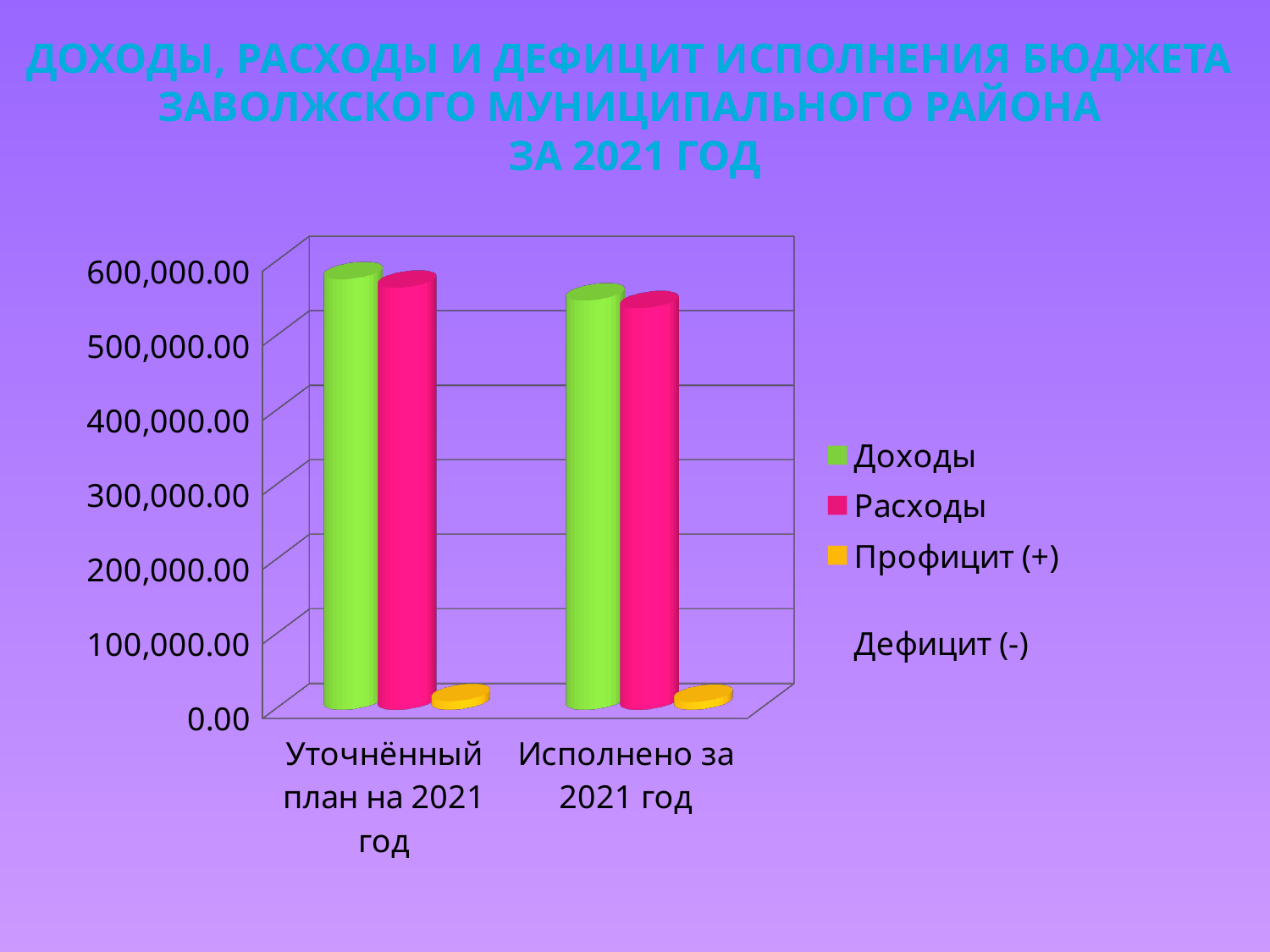
What is the title of the slide containing the chart? ДОХОДЫ, РАСХОДЫ И ДЕФИЦИТ ИСПОЛНЕНИЯ БЮДЖЕТА ЗАВОЛЖСКОГО МУНИЦИПАЛЬНОГО РАЙОНА ЗА 2021 ГОД Does the value of Доходы rise or fall from Уточнённый план на 2021 год to Исполнено за 2021 год? fall Which colour represents the Расходы series in the chart? pink Is the value of Доходы for Уточнённый план на 2021 год greater or less than 500,000.00? greater What kind of chart is shown on the slide? bar chart How many categories are shown on the x axis of the chart? 2 How many series does the chart legend list? 3 Does the value of Расходы rise or fall from Уточнённый план на 2021 год to Исполнено за 2021 год? fall Is the value of Расходы for Исполнено за 2021 год greater or less than 500,000.00? greater Which series has the lowest value in the Исполнено за 2021 год category? Профицит (+) Дефицит (-) Is the value of Профицит (+) Дефицит (-) for Уточнённый план на 2021 год greater or less than 100,000.00? less